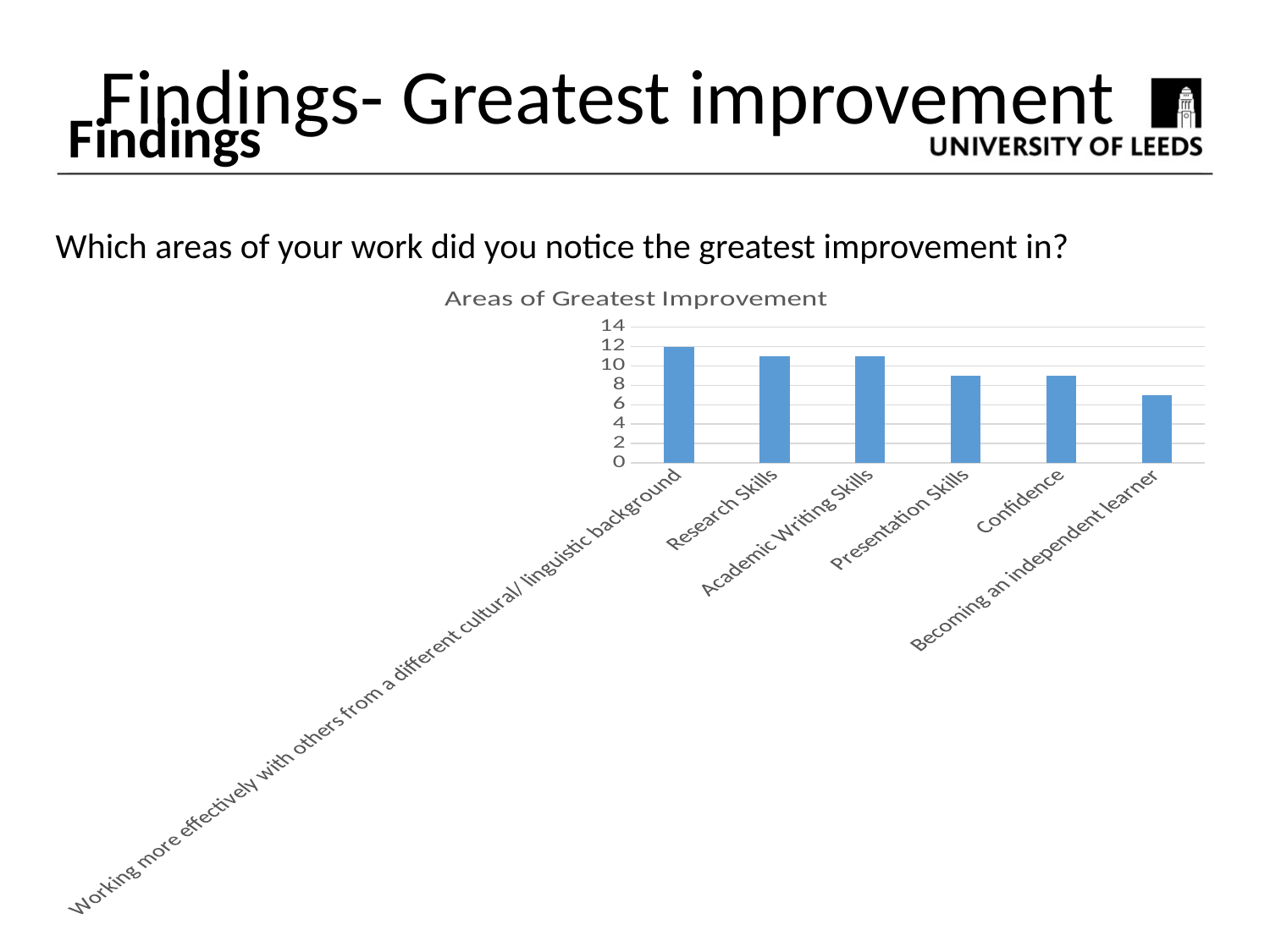
What is the value for 'Working more effectively with others from a different cultural/ linguistic background'? 12 What kind of chart is shown on the slide? bar chart Is the value for Research Skills greater or less than 10? greater What is the title of the chart? Areas of Greatest Improvement Which is larger, the value for Research Skills or the value for Presentation Skills? Research Skills Which category has the highest value in the chart? Working more effectively with others from a different cultural/ linguistic background How many categories are plotted in the chart? 6 Do the values generally rise or fall moving from left to right across the categories? fall Is the value for Presentation Skills greater or less than 10? less Which category has the lowest value in the chart? Becoming an independent learner Is the value for Becoming an independent learner greater or less than 8? less Which is larger, the value for Confidence or the value for Becoming an independent learner? Confidence